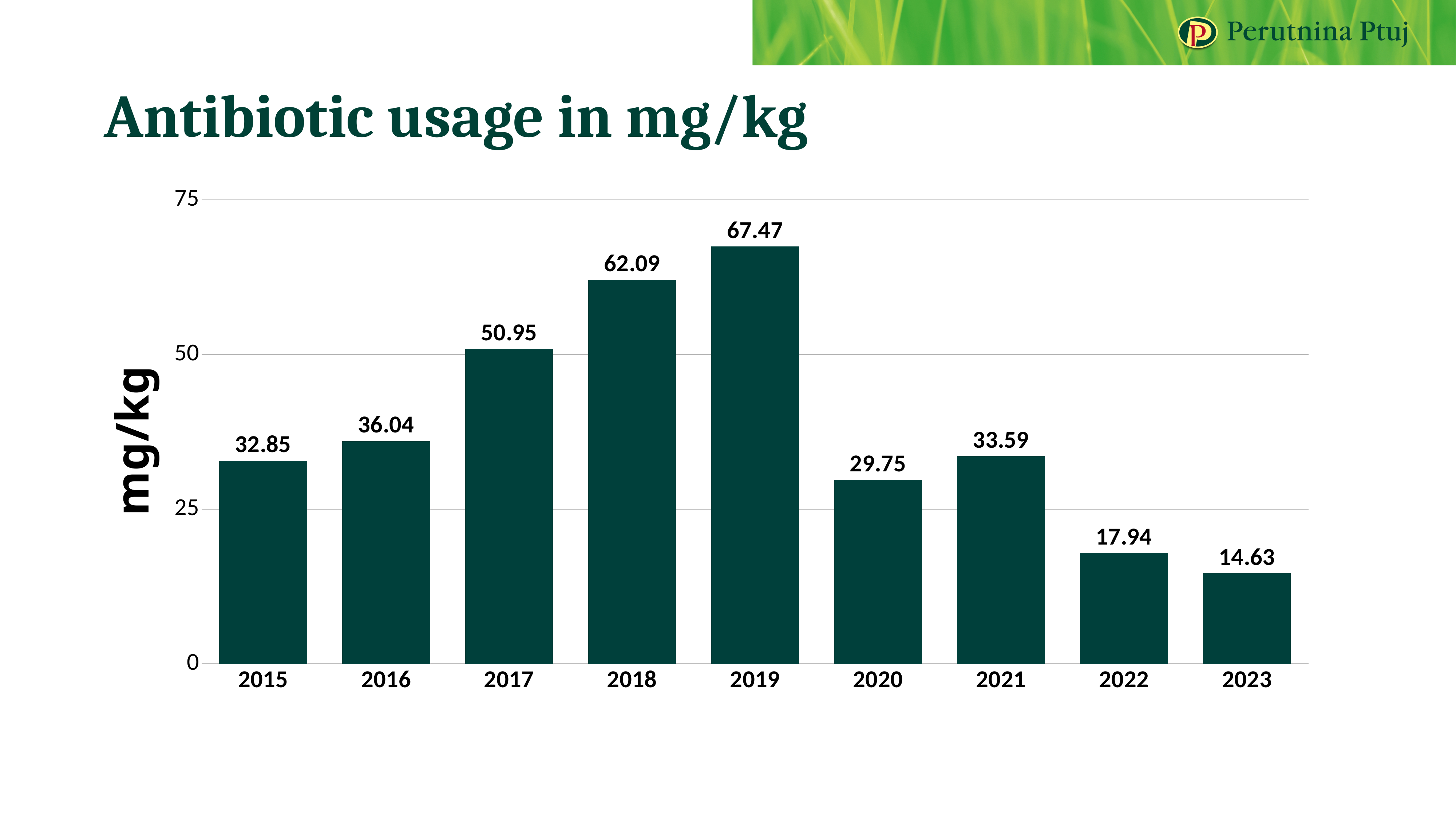
What is the difference between the values for 2019 and 2023? 52.84 Which is larger, the value for 2016 or the value for 2021? 2016 What is the antibiotic usage value for 2023? 14.63 Which year has the highest antibiotic usage? 2019 Which year has the lowest antibiotic usage? 2023 How many years are shown on the x axis? 9 What is the difference between the values for 2018 and 2017? 11.14 Is the value for 2020 greater or less than 25? greater What kind of chart is shown on the slide? bar chart Do the values rise or fall from 2019 to 2023? fall What is the antibiotic usage value for 2017? 50.95 What is the antibiotic usage value for 2019? 67.47